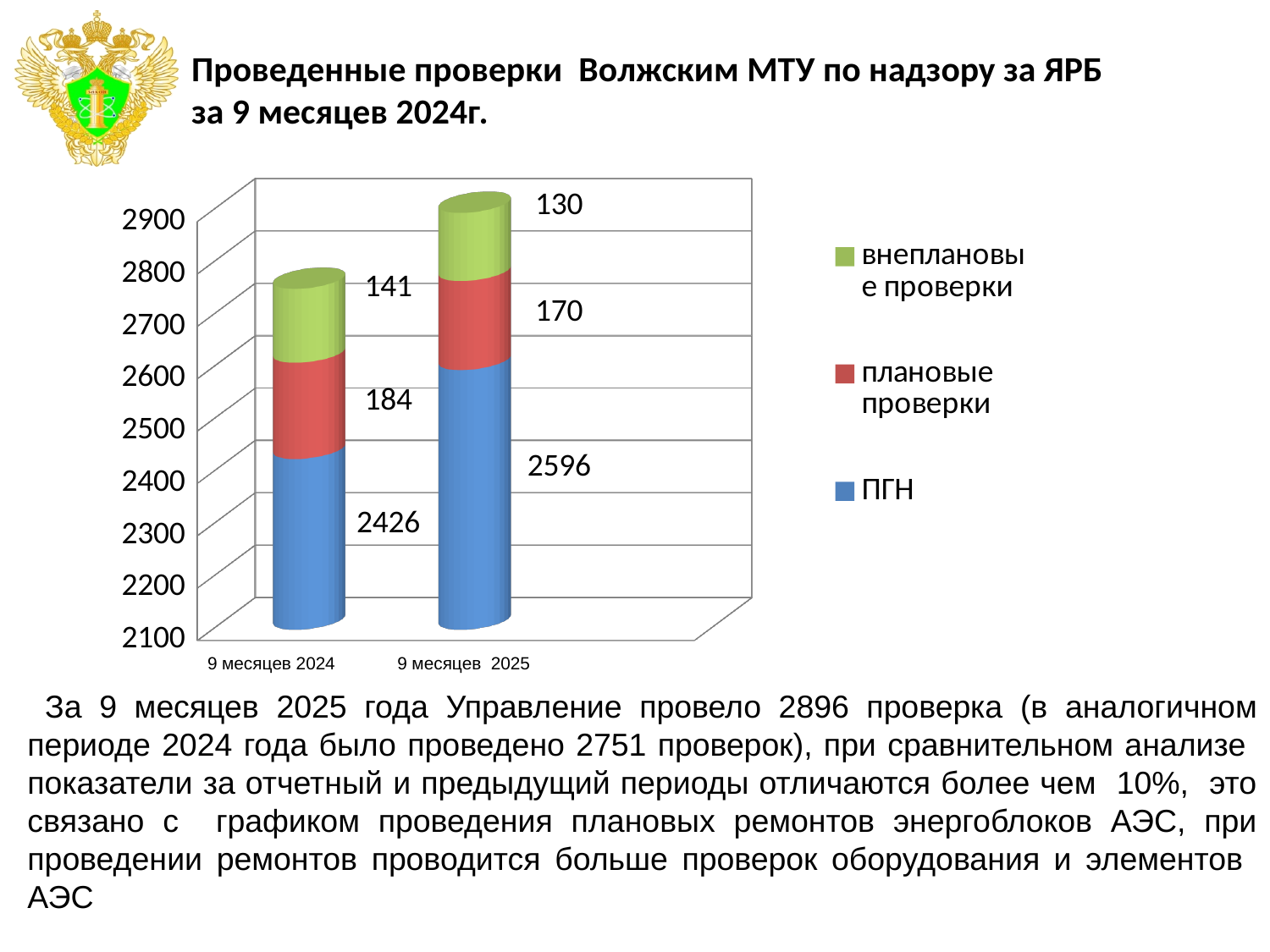
How many series does the legend list? 3 Which period has the larger value for плановые проверки, 9 месяцев 2024 or 9 месяцев 2025? 9 месяцев 2024 What is the difference between the ПГН values for 9 месяцев 2025 and 9 месяцев 2024? 170 What is the value of ПГН for 9 месяцев 2025? 2596 What is the value of внеплановые проверки for 9 месяцев 2025? 130 What is the value of ПГН for 9 месяцев 2024? 2426 What is the value of плановые проверки for 9 месяцев 2024? 184 Which legend entry is shown in green? внеплановые проверки What is the total of the stacked bar for 9 месяцев 2025? 2896 What type of chart is shown on the slide? stacked bar chart How many categories are shown on the x axis? 2 What is the total of the stacked bar for 9 месяцев 2024? 2751